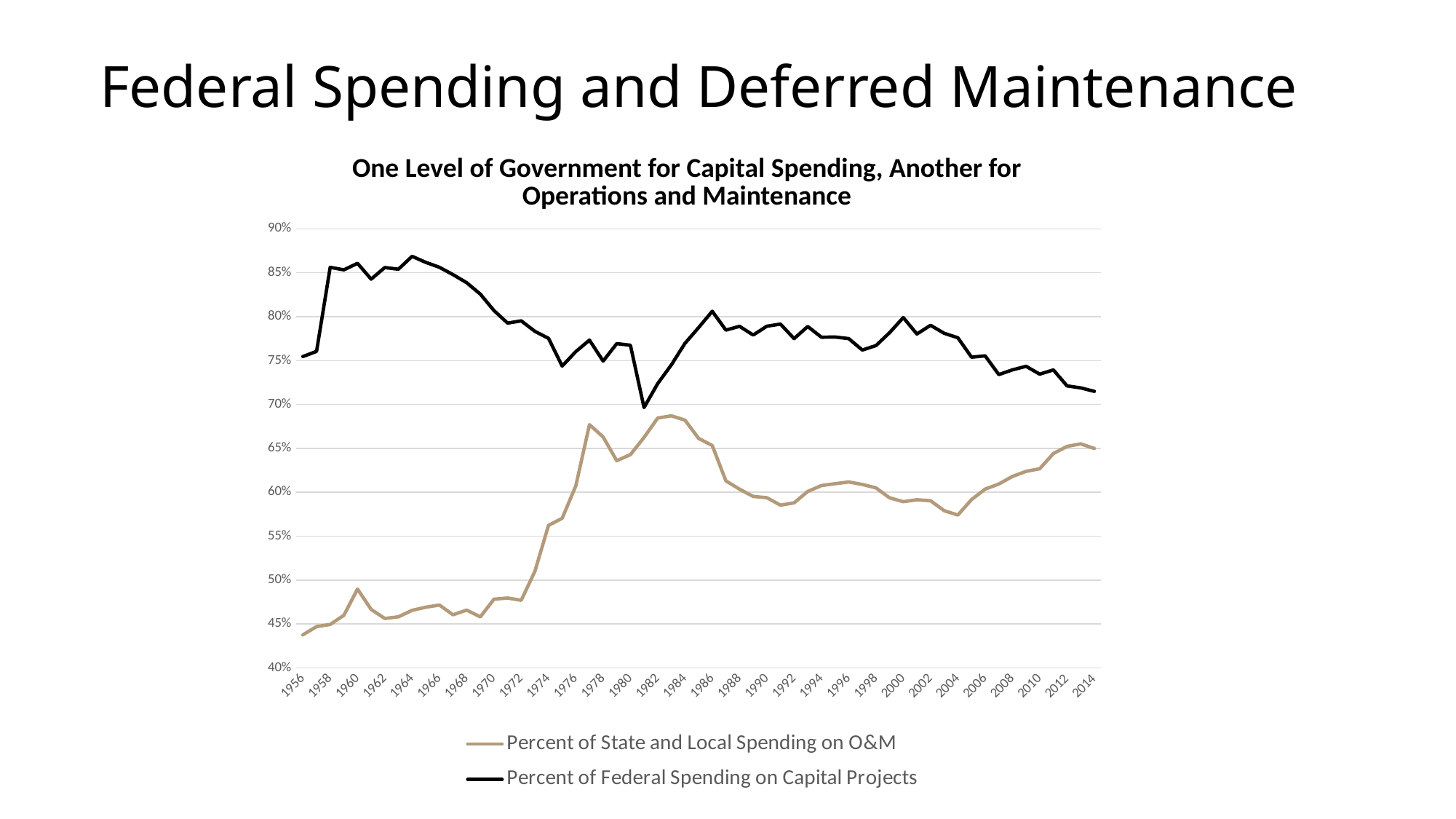
Which series reaches the highest value anywhere on the chart? Percent of Federal Spending on Capital Projects What is the title of the chart? One Level of Government for Capital Spending, Another for Operations and Maintenance Is the value for Percent of Federal Spending on Capital Projects in 1956 greater or less than 80%? less Is the value for Percent of State and Local Spending on O&M in 1984 greater or less than 65%? greater Is the value for Percent of State and Local Spending on O&M in 1956 greater or less than 50%? less Which series is drawn with the black line? Percent of Federal Spending on Capital Projects How many series does the legend list? 2 Overall from 1956 to 2014, does the Percent of State and Local Spending on O&M rise or fall? rise What kind of chart is shown on the slide? line chart In 2014, which series has the higher value: Percent of State and Local Spending on O&M or Percent of Federal Spending on Capital Projects? Percent of Federal Spending on Capital Projects